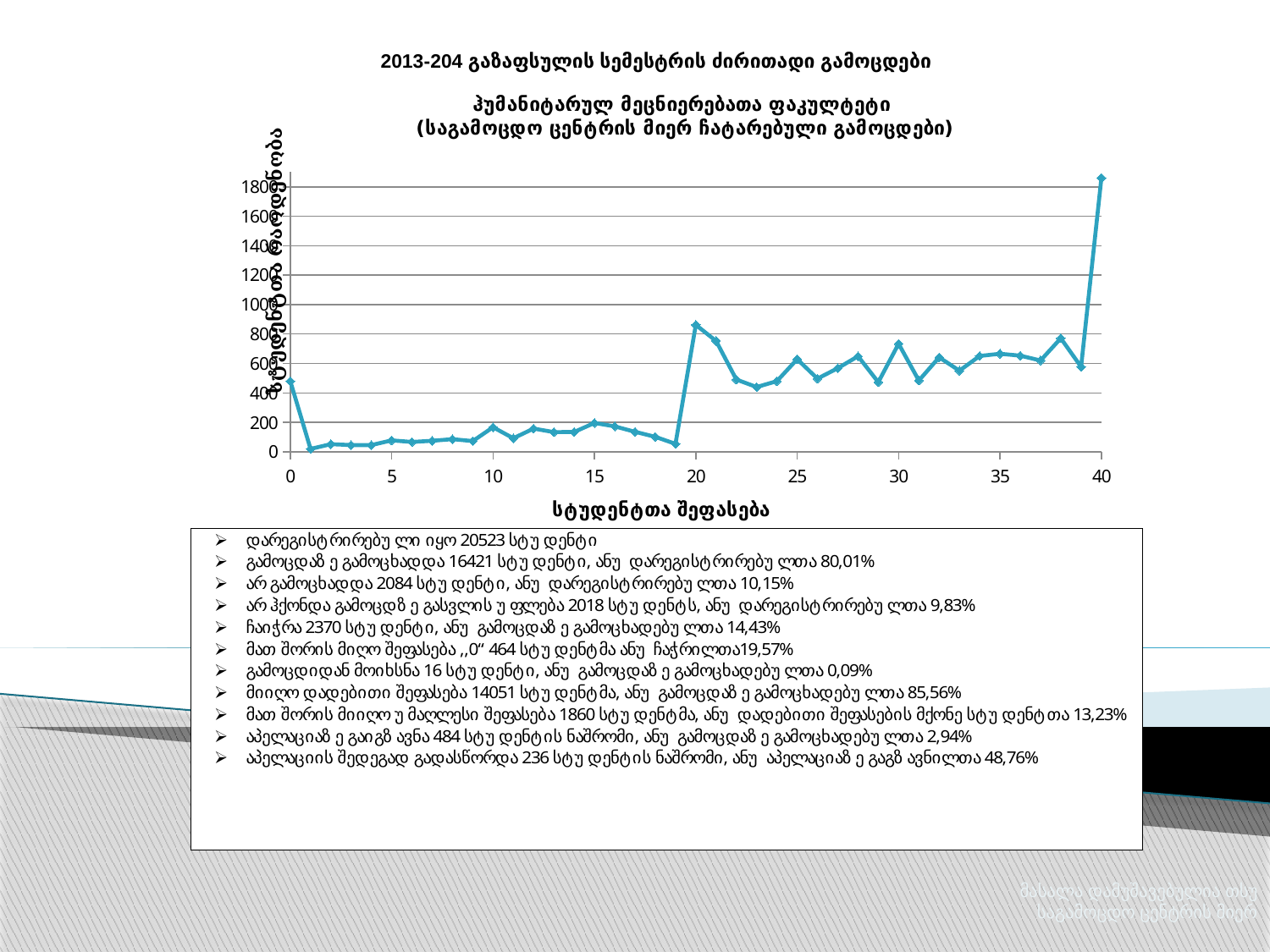
Is the value at x = 0 greater or less than 600? less Is the value at x = 15 greater or less than 400? less Does the line rise or fall between x = 0 and x = 1? fall What kind of chart is shown on the slide? line chart Is the value at x = 23 greater or less than 600? less What is the label of the x axis? სტუდენტთა შეფასება At which x-axis value (student score) does the line reach its highest point? 40 Which has the larger value, x = 10 or x = 20? 20 Does the line rise or fall between x = 39 and x = 40? rise